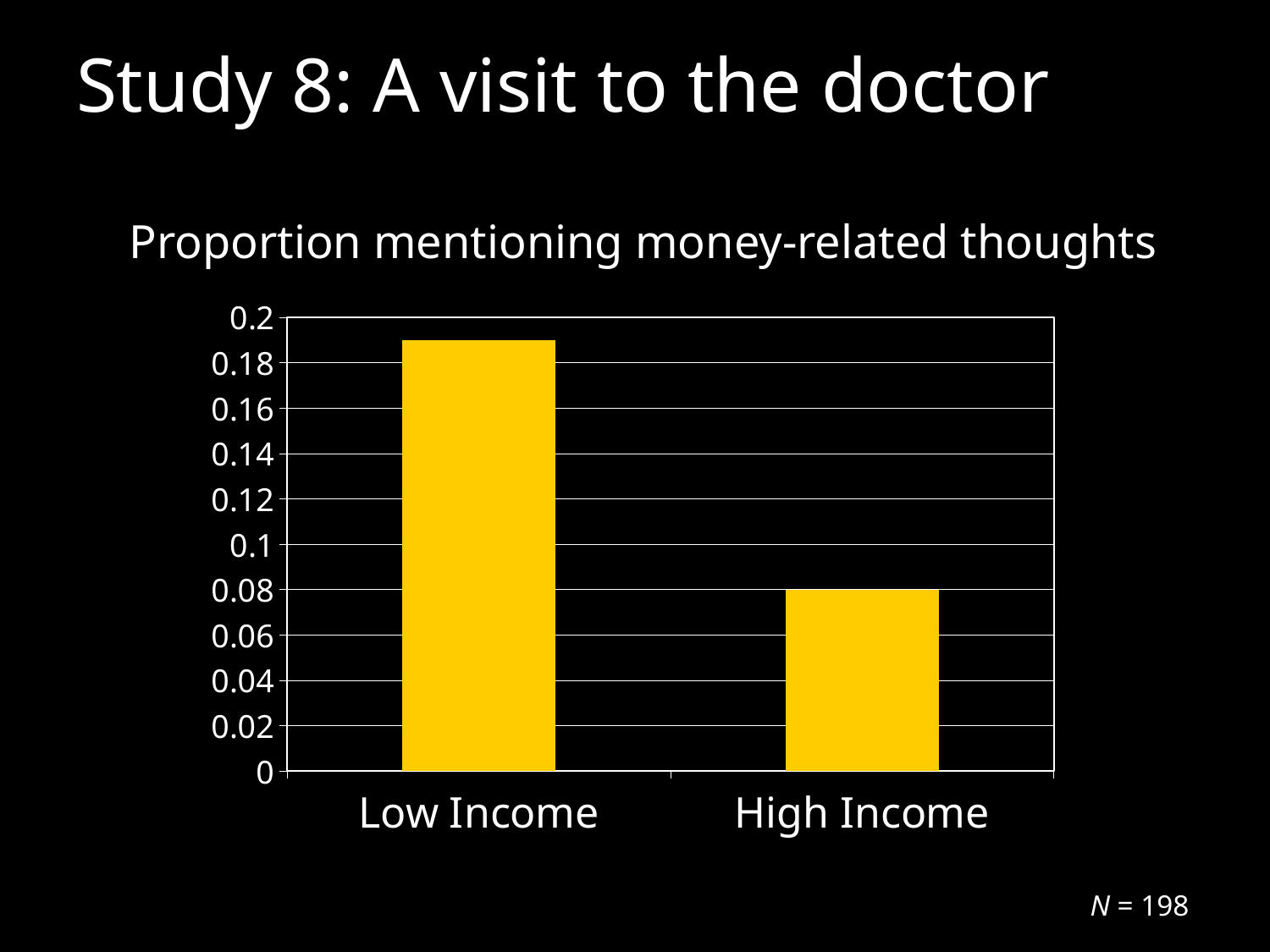
Is the value for Low Income greater or less than 0.1? greater Is the value for Low Income greater or less than 0.18? greater Is the value for High Income greater or less than 0.1? less What is the maximum value shown on the y axis? 0.2 Which category has the highest proportion mentioning money-related thoughts? Low Income What colour are the bars in the chart? yellow What kind of chart is shown on the slide? bar chart How many categories are shown on the x axis of the chart? 2 What is the proportion mentioning money-related thoughts for High Income? 0.08 What is the title of the chart? Proportion mentioning money-related thoughts Which is larger, the value for Low Income or the value for High Income? Low Income Which category has the lowest proportion mentioning money-related thoughts? High Income